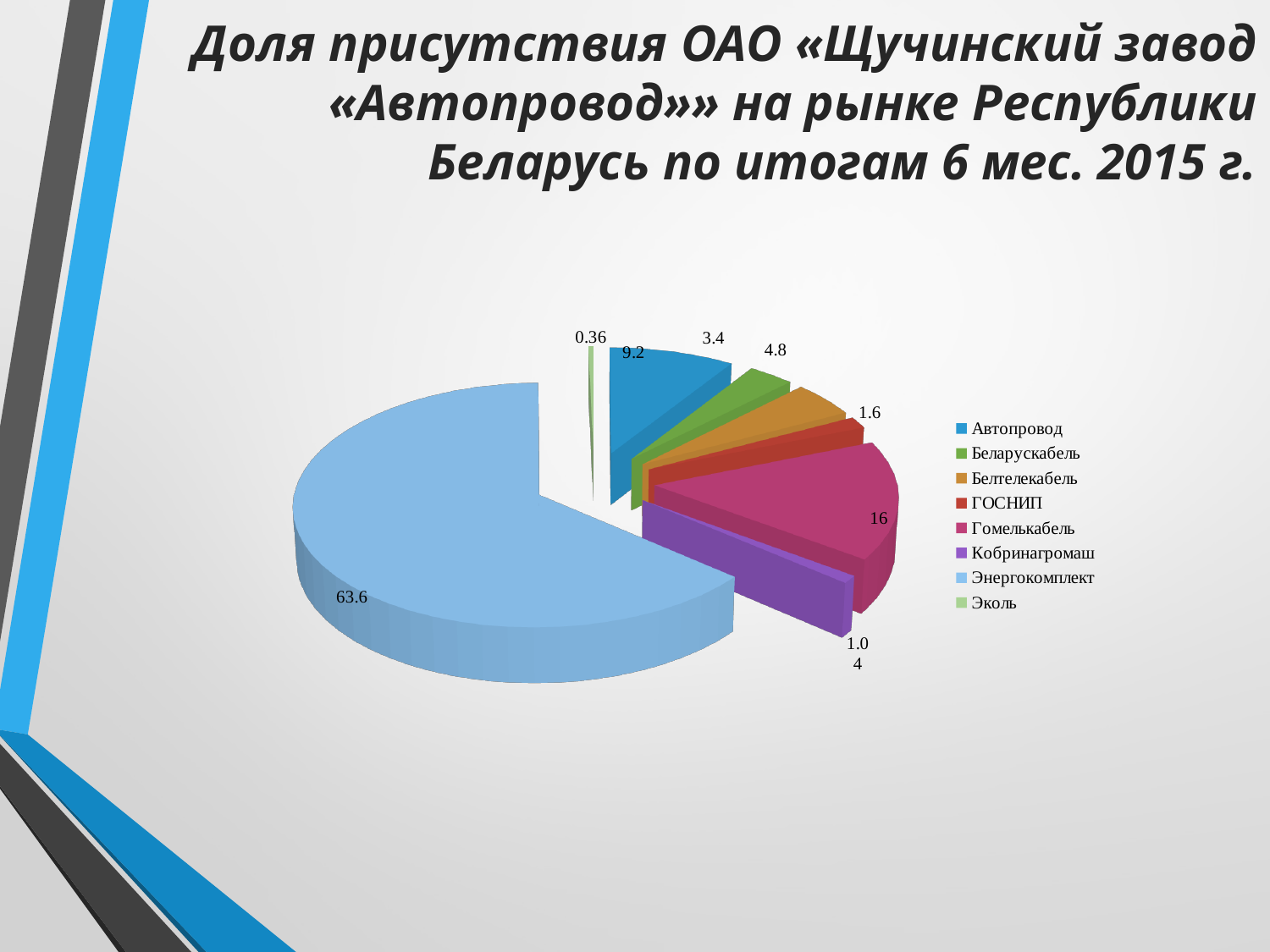
What is the value shown for Эколь? 0.36 Which is larger, the value for Гомелькабель or the value for Автопровод? Гомелькабель What is the value shown for Гомелькабель? 16 What is the value shown for Белтелекабель? 4.8 How many categories does the legend of the pie chart list? 8 Which category has the smallest slice of the pie? Эколь What colour is the slice for Гомелькабель? magenta (pink-red) What is the value shown for Энергокомплект? 63.6 What is the value shown for Автопровод? 9.2 Which category has the largest slice of the pie? Энергокомплект What kind of chart is shown on the slide? pie chart What is the difference between the values for Белтелекабель and Беларускабель? 1.4